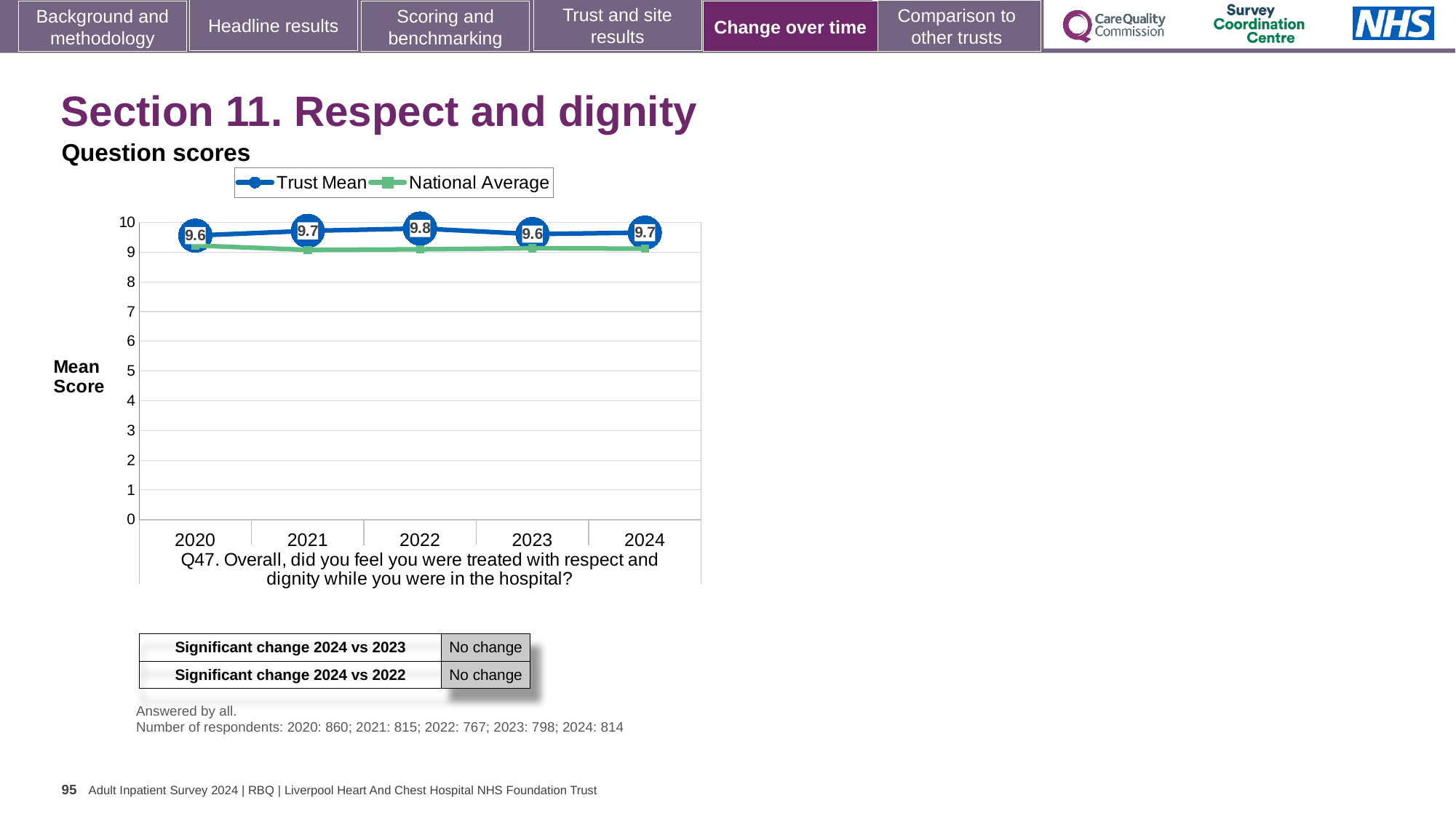
Is the National Average value for 2024 greater or less than 8? greater What is the Trust Mean score for 2022? 9.8 How many series does the legend list? 2 In which year is the Trust Mean score highest? 2022 Does the Trust Mean score rise or fall from 2022 to 2023? Fall How many years are plotted on the x axis? 5 What is the Trust Mean score for 2020? 9.6 What kind of chart is shown on the slide? Line chart What is the Trust Mean score for 2024? 9.7 Which is larger, the Trust Mean score for 2021 or for 2023? 2021 What are the two series named in the legend? Trust Mean and National Average What is the difference between the Trust Mean scores for 2022 and 2023? 0.2